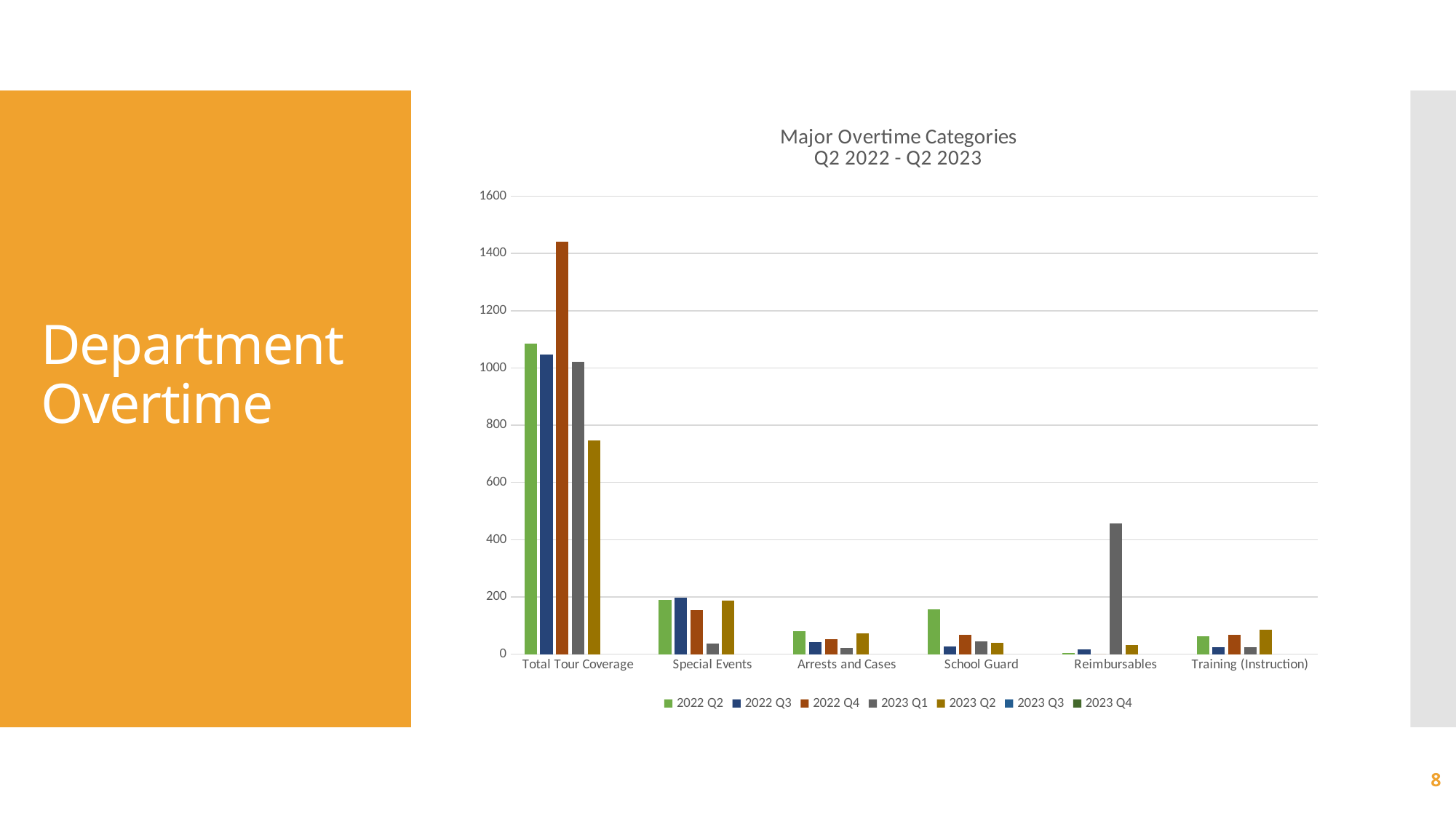
What kind of chart is shown on the slide? Bar chart How many series does the legend list? 7 For Reimbursables, which is larger: the 2023 Q1 bar or the 2023 Q2 bar? 2023 Q1 Within Total Tour Coverage, which quarter has the lowest bar? 2023 Q2 What is the title of the chart? Major Overtime Categories Q2 2022 - Q2 2023 How many overtime categories are shown on the x axis? 6 Is the 2022 Q4 value for Total Tour Coverage greater or less than 1200? greater For Total Tour Coverage, which is larger: the 2022 Q2 bar or the 2022 Q4 bar? 2022 Q4 Within Total Tour Coverage, which quarter has the highest bar? 2022 Q4 Is the 2023 Q2 value for Total Tour Coverage greater or less than 800? less Which category has the tallest bar overall? Total Tour Coverage Is the 2023 Q1 value for Reimbursables greater or less than 400? greater